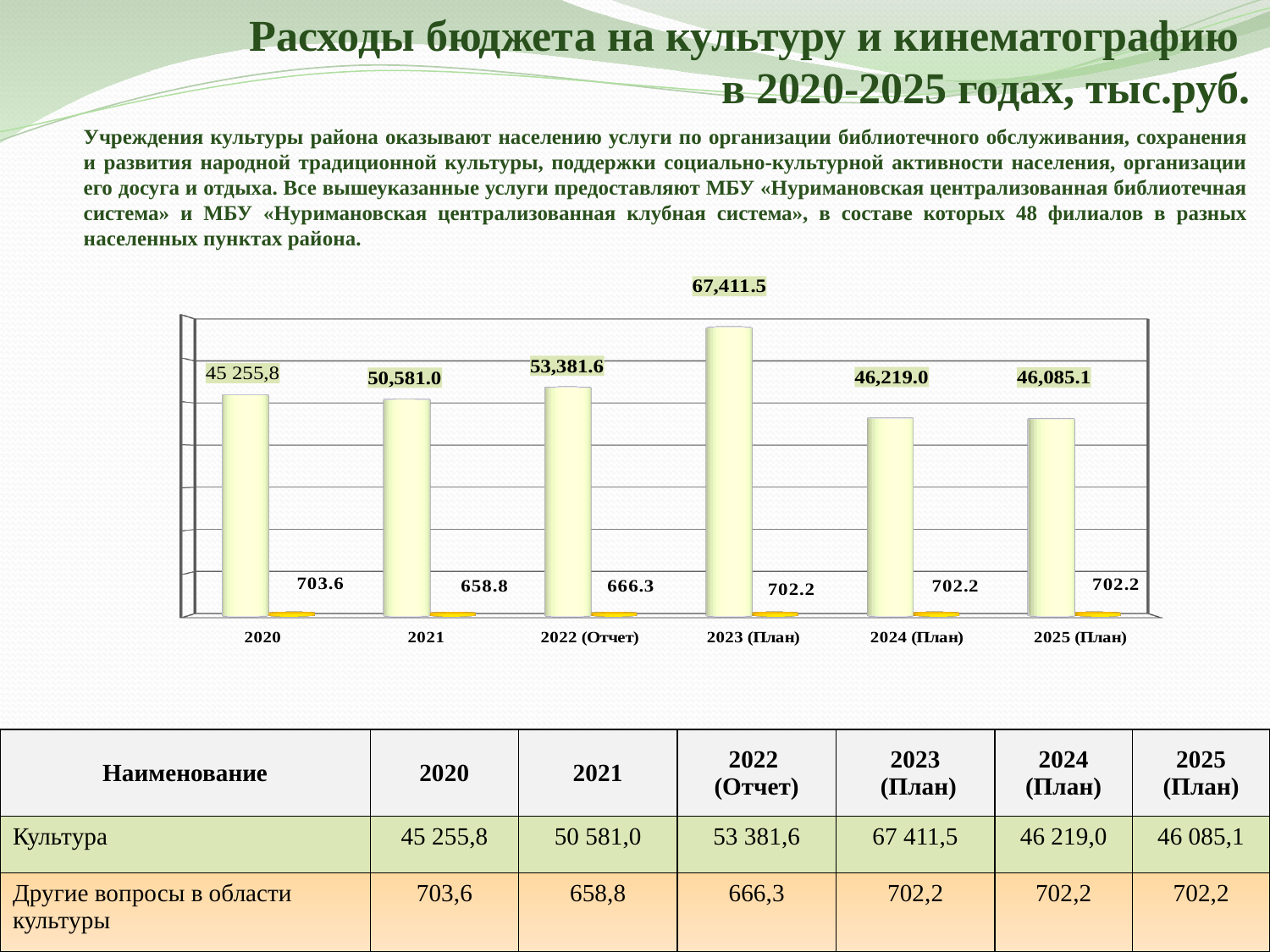
What is the value of the small bar for 2020? 703.6 How many years are shown on the x axis of the chart? 6 Which is larger, the tall bar for 2024 (План) or the tall bar for 2025 (План)? 2024 (План) What is the value of the tall bar for 2023 (План)? 67,411.5 What is the value of the tall bar for 2022 (Отчет)? 53,381.6 What is the difference between the small bar values for 2020 and 2021? 44.8 Which year has the lowest value among the small bars? 2021 What is the value of the small bar for 2021? 658.8 Which year has the highest value among the tall bars? 2023 (План) What type of chart is shown on the slide? Bar chart What is the difference between the tall bar values for 2023 (План) and 2022 (Отчет)? 14,029.9